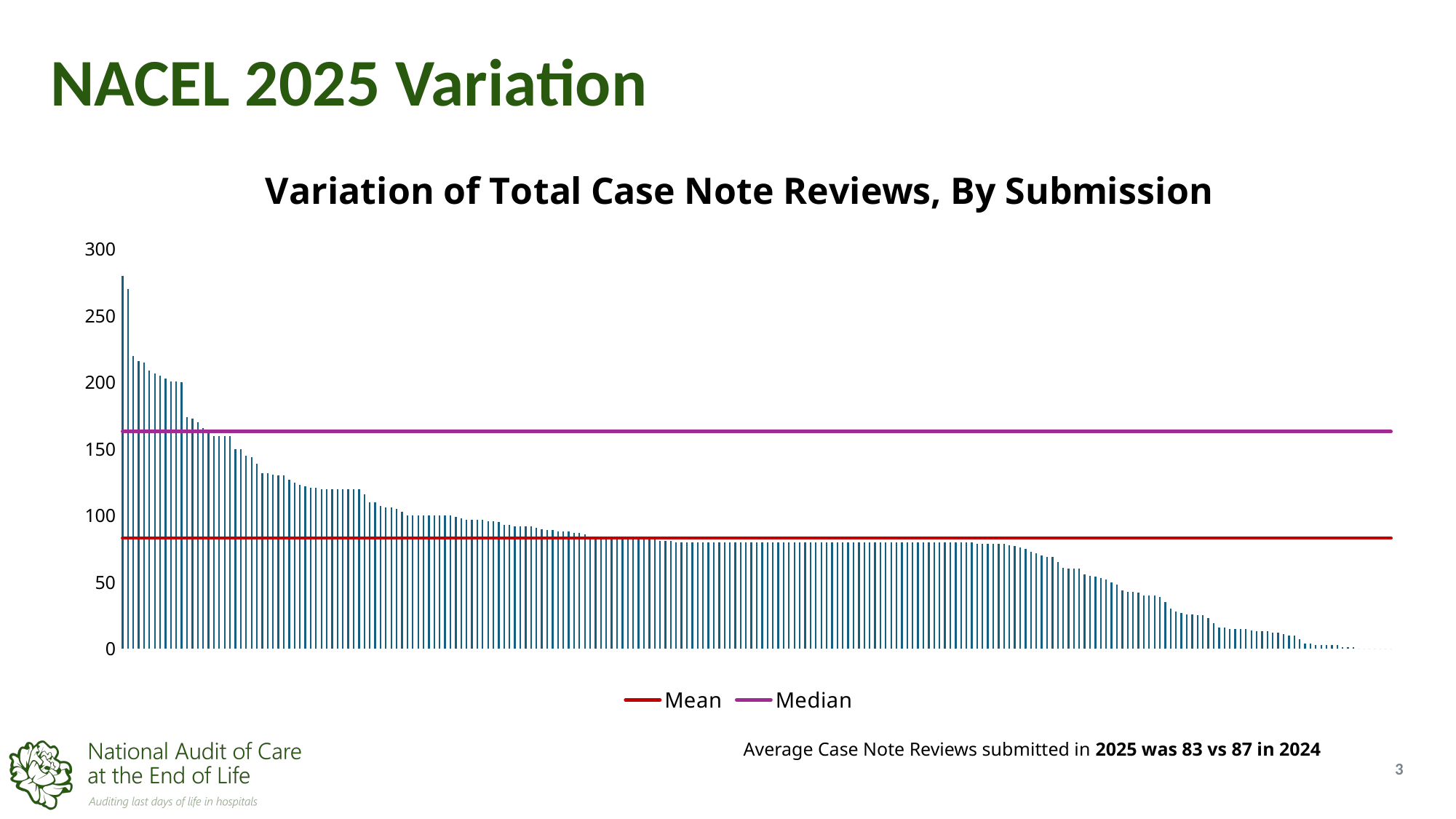
What is the title of the chart? Variation of Total Case Note Reviews, By Submission Is the Mean line greater or less than 100? less What kind of chart is shown on the slide? Combination bar and line chart (bars with Mean and Median lines) How many series does the chart legend list? 2 Is the value of the tallest bar greater or less than 250? greater Is the Median line higher or lower than the Mean line on the chart? higher What is the highest value shown on the y axis? 300 Do the bar values rise or fall from left to right along the x axis? Fall According to the slide, what was the average number of Case Note Reviews submitted in 2025? 83 According to the slide, what was the average number of Case Note Reviews submitted in 2024? 87 Which two entries appear in the chart legend? Mean and Median Is the Median line greater or less than 150? greater